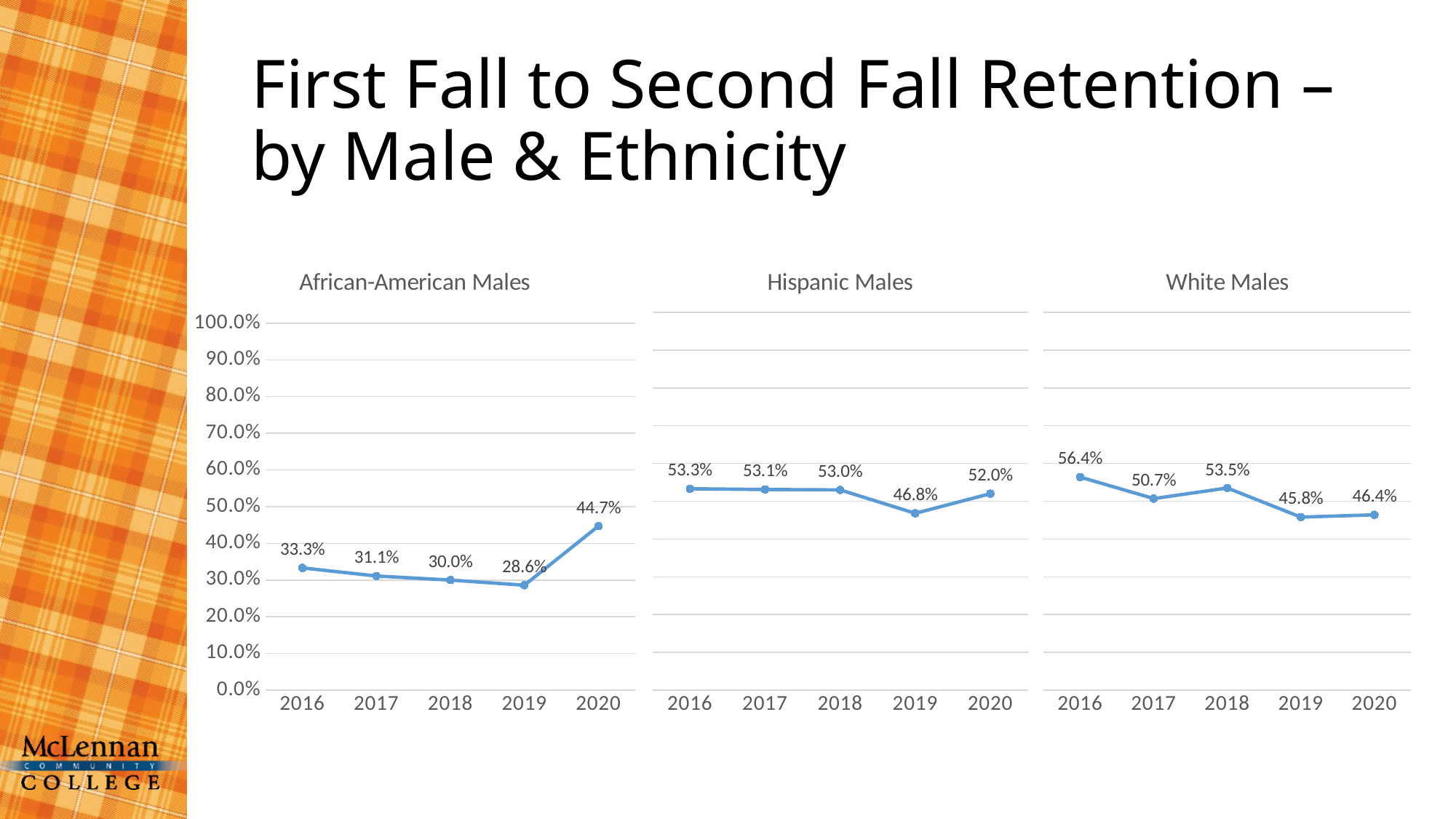
What kind of chart is the African-American Males chart? line chart In the African-American Males chart, do the values rise or fall from 2016 to 2019? fall In the African-American Males chart, what is the value for 2020? 44.7% In the African-American Males chart, what is the difference between the 2020 and 2019 values? 16.1% In the Hispanic Males chart, what is the value for 2019? 46.8% In the White Males chart, which is larger, the value for 2018 or the value for 2019? 2018 In the African-American Males chart, which year has the lowest value? 2019 In the White Males chart, what is the value for 2017? 50.7% In the Hispanic Males chart, which year has the lowest value? 2019 How many years are plotted in the Hispanic Males chart? 5 In the White Males chart, which year has the highest value? 2016 In the White Males chart, what is the difference between the 2016 and 2019 values? 10.6%